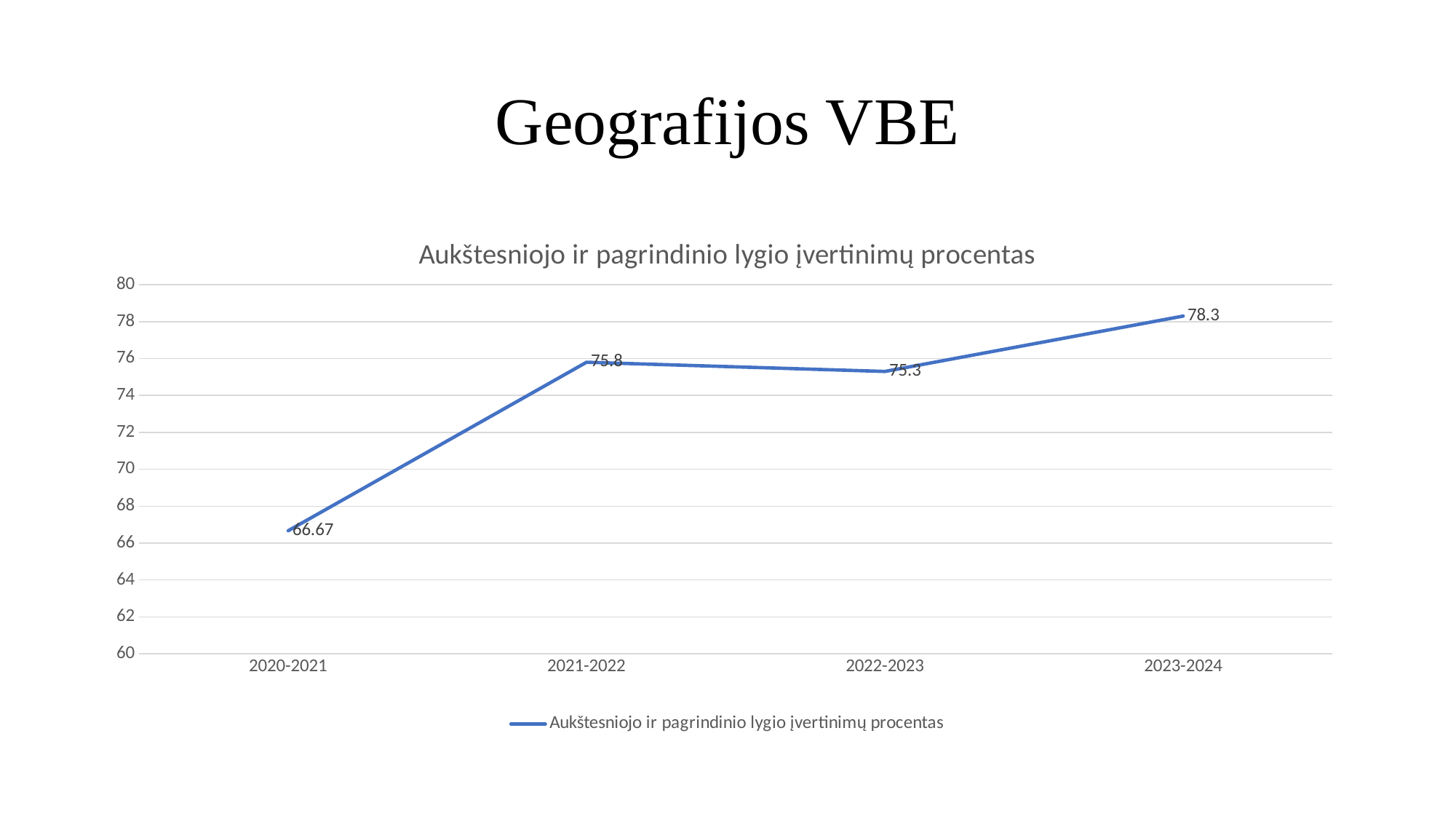
What is the title of the chart? Aukštesniojo ir pagrindinio lygio įvertinimų procentas Which is larger, the value for 2021-2022 or the value for 2023-2024? 2023-2024 What is the difference between the values for 2021-2022 and 2022-2023? 0.5 What is the value for 2020-2021? 66.67 What is the difference between the values for 2023-2024 and 2020-2021? 11.63 Which school year has the highest value? 2023-2024 What is the value for 2021-2022? 75.8 What kind of chart is shown on the slide? line chart What is the value for 2023-2024? 78.3 How many school years are plotted on the chart? 4 What is the value for 2022-2023? 75.3 Which school year has the lowest value? 2020-2021